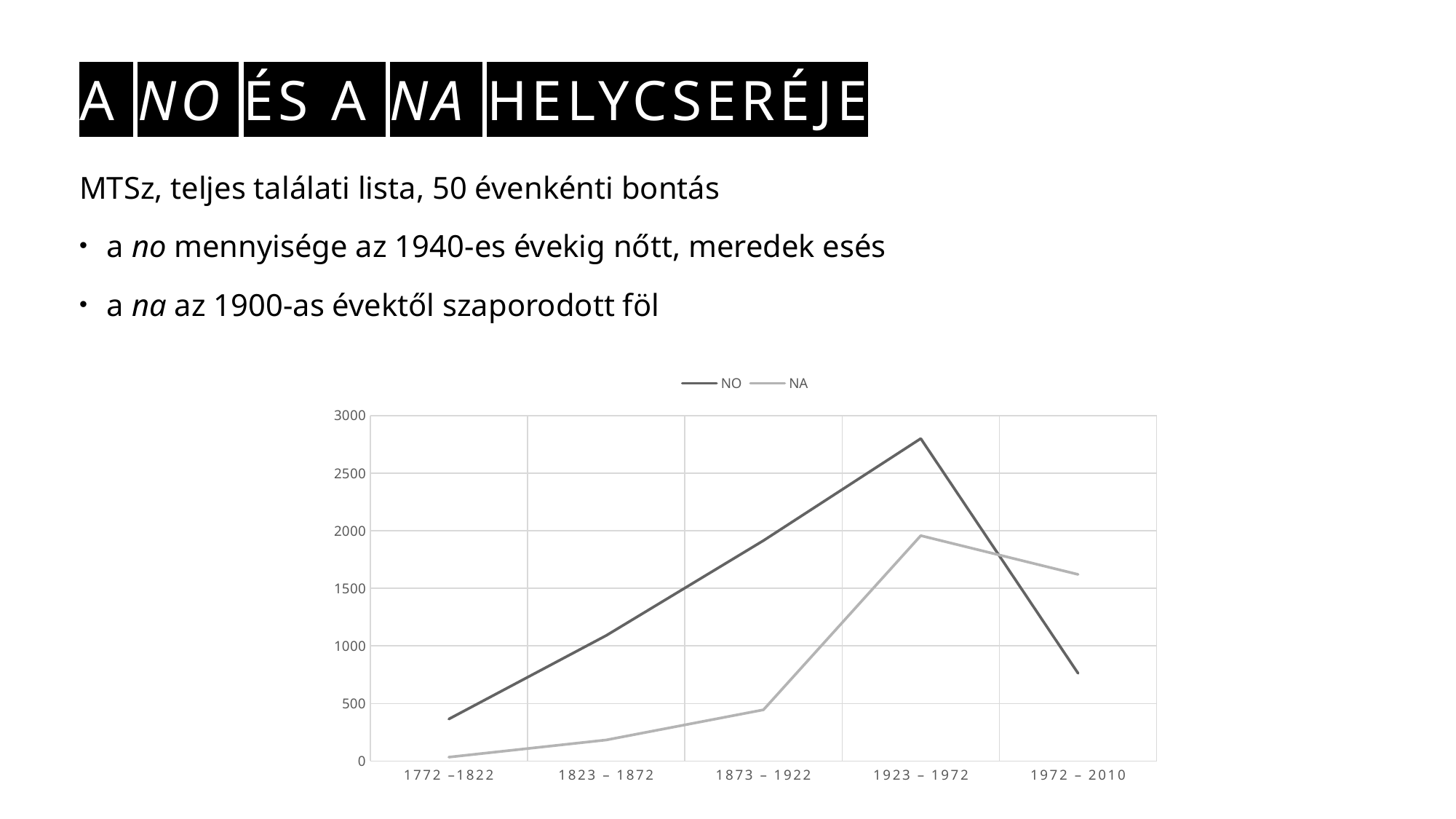
In which period does the NA series reach its highest value? 1923 – 1972 In which period is the NO series lowest? 1772 –1822 Is the value for NA in 1972 – 2010 greater or less than 1500? greater Is the value for NA in 1772 –1822 greater or less than 500? less How many series does the legend list? 2 What kind of chart is shown on the slide? line chart In which period does the NO series reach its highest value? 1923 – 1972 Does the NO series rise or fall from 1923 – 1972 to 1972 – 2010? fall How many periods are shown on the x axis? 5 Which series has the larger value in 1972 – 2010, NO or NA? NA Is the value for NO in 1972 – 2010 greater or less than 1000? less